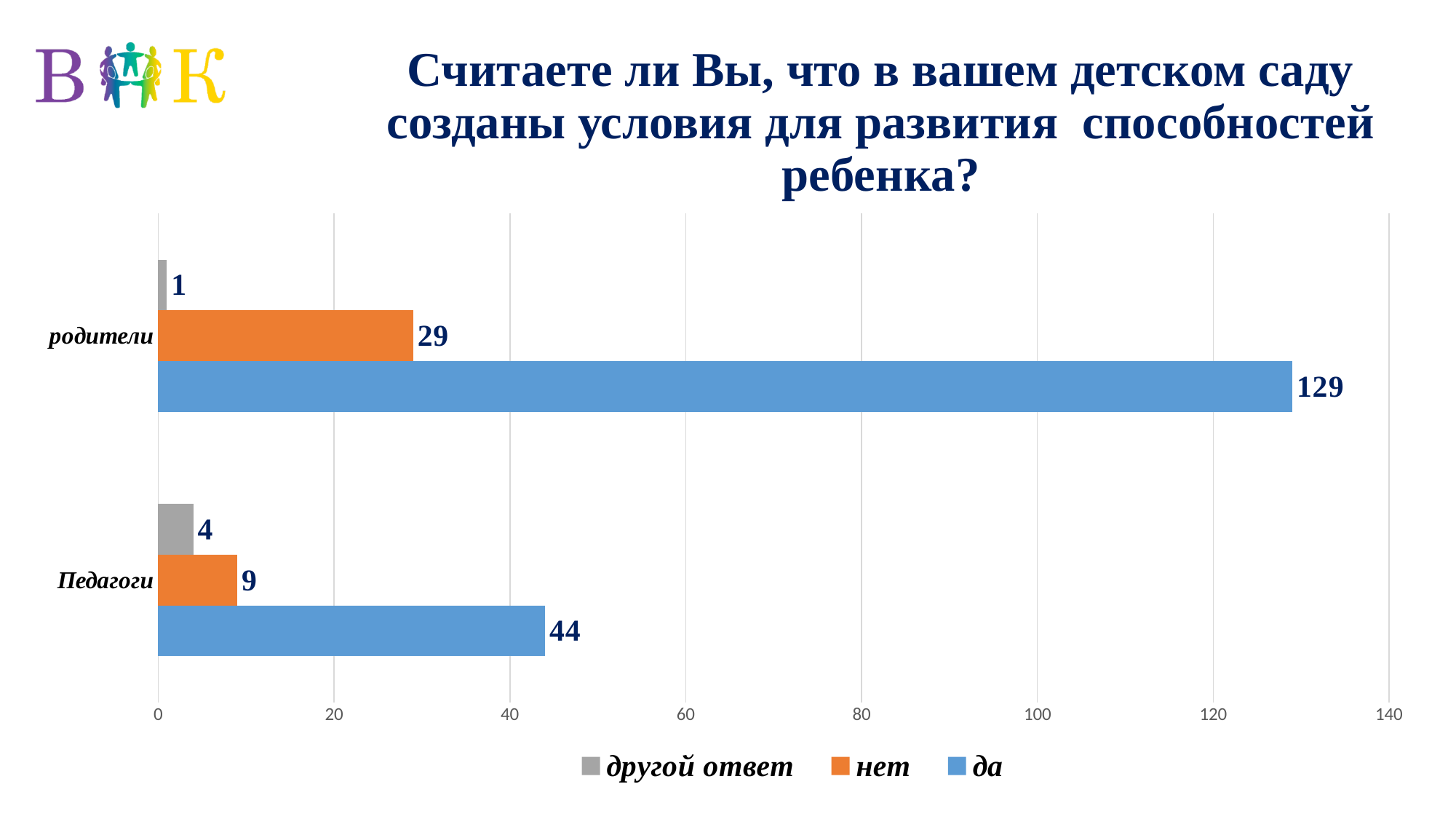
What is the value for "другой ответ" for родители? 1 What kind of chart is shown on the slide? bar chart How many categories are shown on the chart? 2 What is the value for "да" for Педагоги? 44 Which category has the lowest value for "другой ответ"? родители What is the value for "нет" for Педагоги? 9 What is the difference between the "да" values for родители and Педагоги? 85 Which category has the highest value for "да"? родители Is the value for "да" for родители greater or less than 120? greater Which is larger: "нет" for родители or "нет" for Педагоги? родители How many series does the legend list? 3 What is the value for "да" for родители? 129